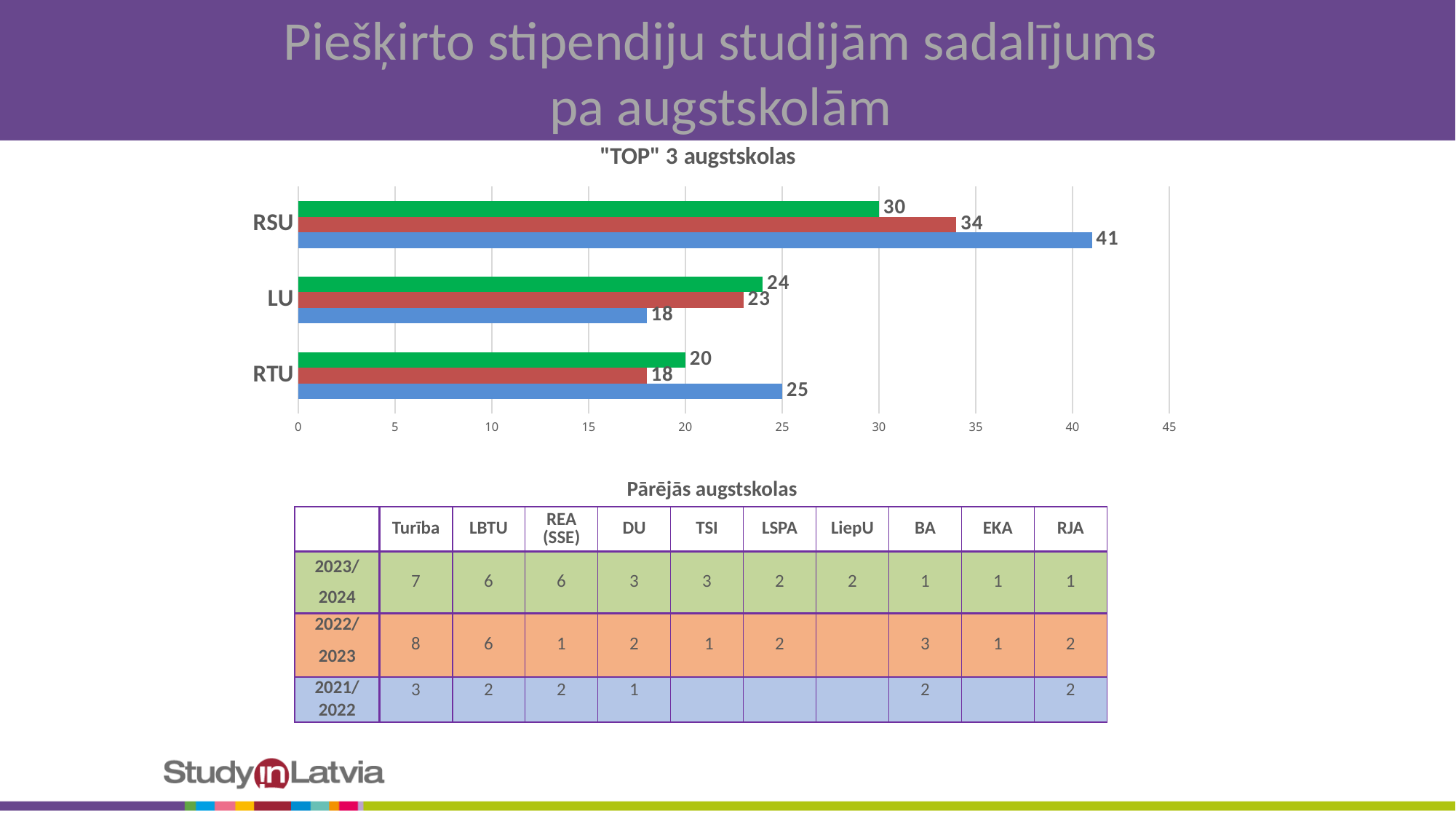
What is the difference between the blue bar and the red bar for RSU? 7 What type of chart is shown on the slide? bar chart What is the title of the chart? "TOP" 3 augstskolas For LU, which is larger: the green bar or the red bar? green bar What is the difference between the blue bar and the green bar for RTU? 5 What is the value of the blue bar for RSU? 41 How many universities are shown on the chart? 3 Which university has the lowest green bar? RTU What is the value of the red bar for RTU? 18 Is the value of the red bar for RSU greater or less than 30? greater What is the value of the green bar for LU? 24 Which university has the highest blue bar? RSU